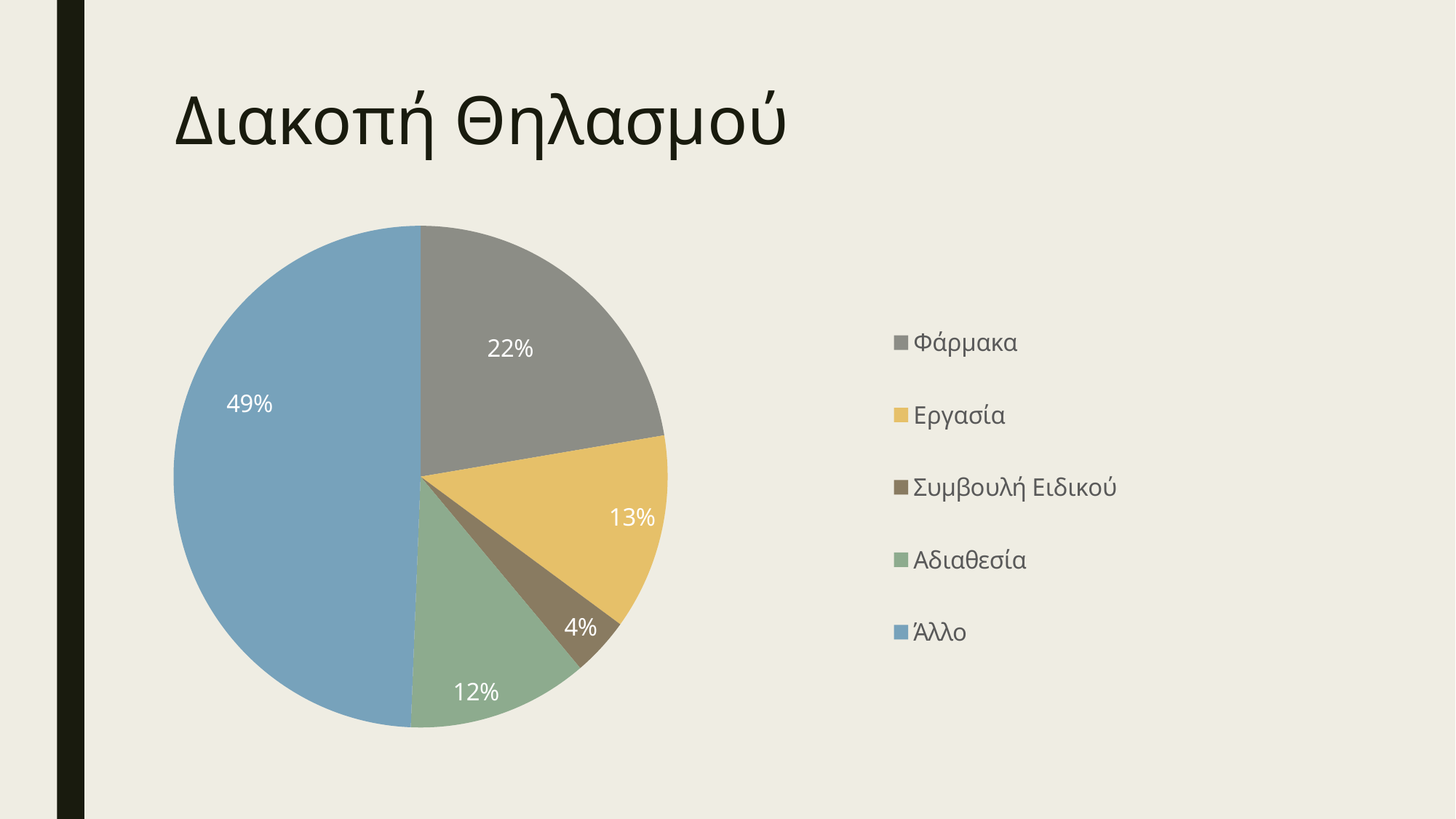
Which category has the largest share of the pie? Άλλο What kind of chart is shown on the slide? pie chart What is the share for Άλλο? 49% What is the share for Αδιαθεσία? 12% How many categories does the pie chart have? 5 What is the difference between the shares for Φάρμακα and Εργασία? 9% What is the title of the slide containing the chart? Διακοπή Θηλασμού Which is larger, the share for Φάρμακα or the share for Αδιαθεσία? Φάρμακα What is the share for Φάρμακα? 22% What is the share for Εργασία? 13% What is the share for Συμβουλή Ειδικού? 4% Which category has the smallest share of the pie? Συμβουλή Ειδικού